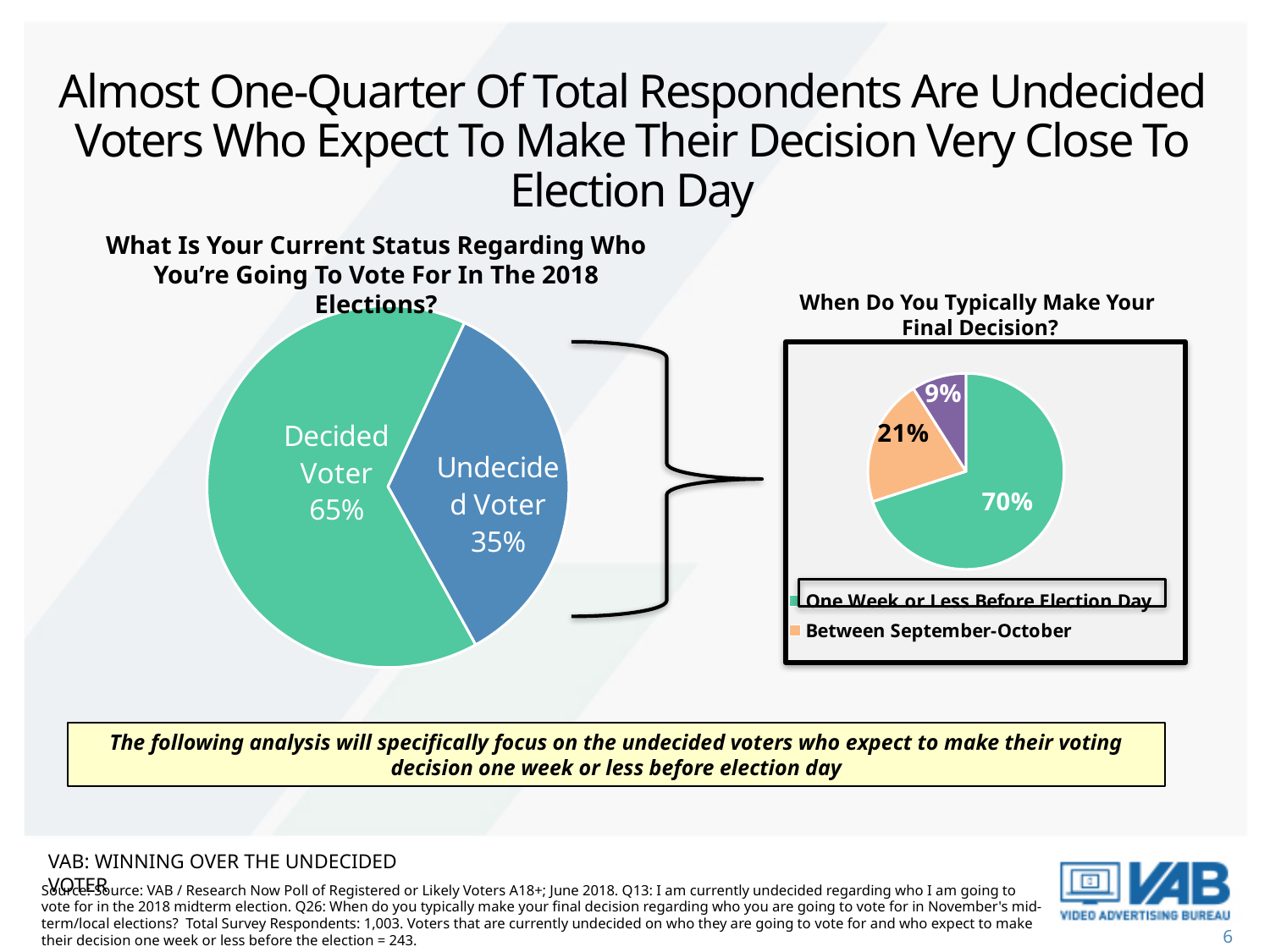
In the 'When Do You Typically Make Your Final Decision?' chart, which category has the largest share? One Week or Less Before Election Day In the left pie chart, what percentage of respondents are Decided Voters? 65% In the 'When Do You Typically Make Your Final Decision?' chart, what percentage make their decision Between September-October? 21% How many slices does the left pie chart have? 2 What type of chart is used on the left of the slide? Pie chart How many slices does the 'When Do You Typically Make Your Final Decision?' pie chart have? 3 In the 'When Do You Typically Make Your Final Decision?' chart, what percentage make their decision One Week or Less Before Election Day? 70% In the left pie chart, which slice is larger, Decided Voter or Undecided Voter? Decided Voter In the left pie chart, what percentage of respondents are Undecided Voters? 35% In the 'When Do You Typically Make Your Final Decision?' chart, what is the smallest percentage shown? 9% In the 'When Do You Typically Make Your Final Decision?' chart, what is the difference in percentage points between the One Week or Less Before Election Day slice and the Between September-October slice? 49 In the left pie chart, what is the difference in percentage points between Decided Voters and Undecided Voters? 30